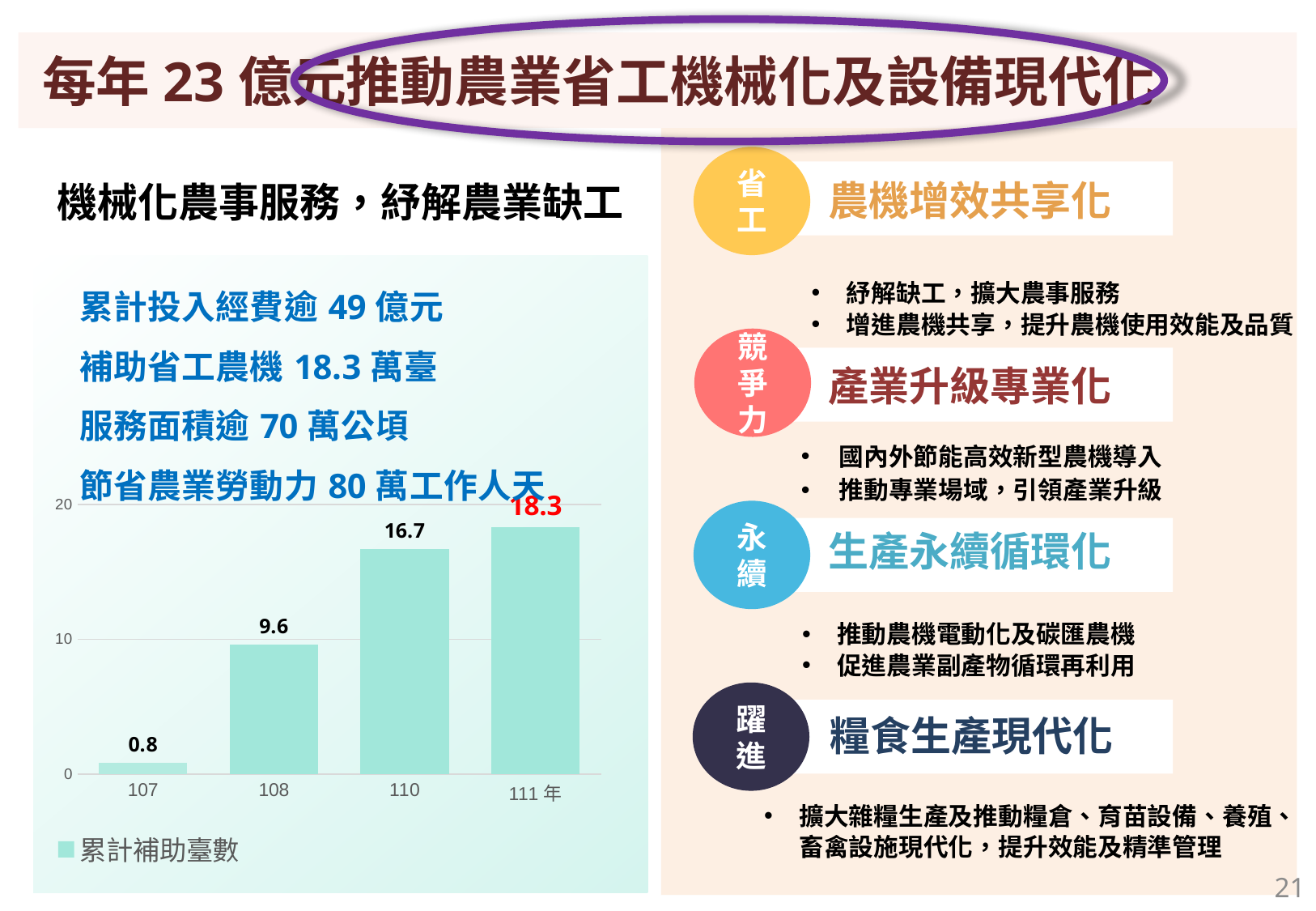
What is the difference between the values for 111 年 and 110? 1.6 Which is larger, the value for 108 or the value for 110? 110 What is the difference between the values for 108 and 107? 8.8 What is the value for 111 年 in the bar chart? 18.3 What is the value for 110 in the bar chart? 16.7 What is the legend entry for the series in the bar chart? 累計補助臺數 Which category has the lowest value in the bar chart? 107 What type of chart is shown on the slide? bar chart What is the value for 108 in the bar chart? 9.6 What is the value for 107 in the bar chart? 0.8 Which category has the highest value in the bar chart? 111 年 How many bars are shown in the chart? 4